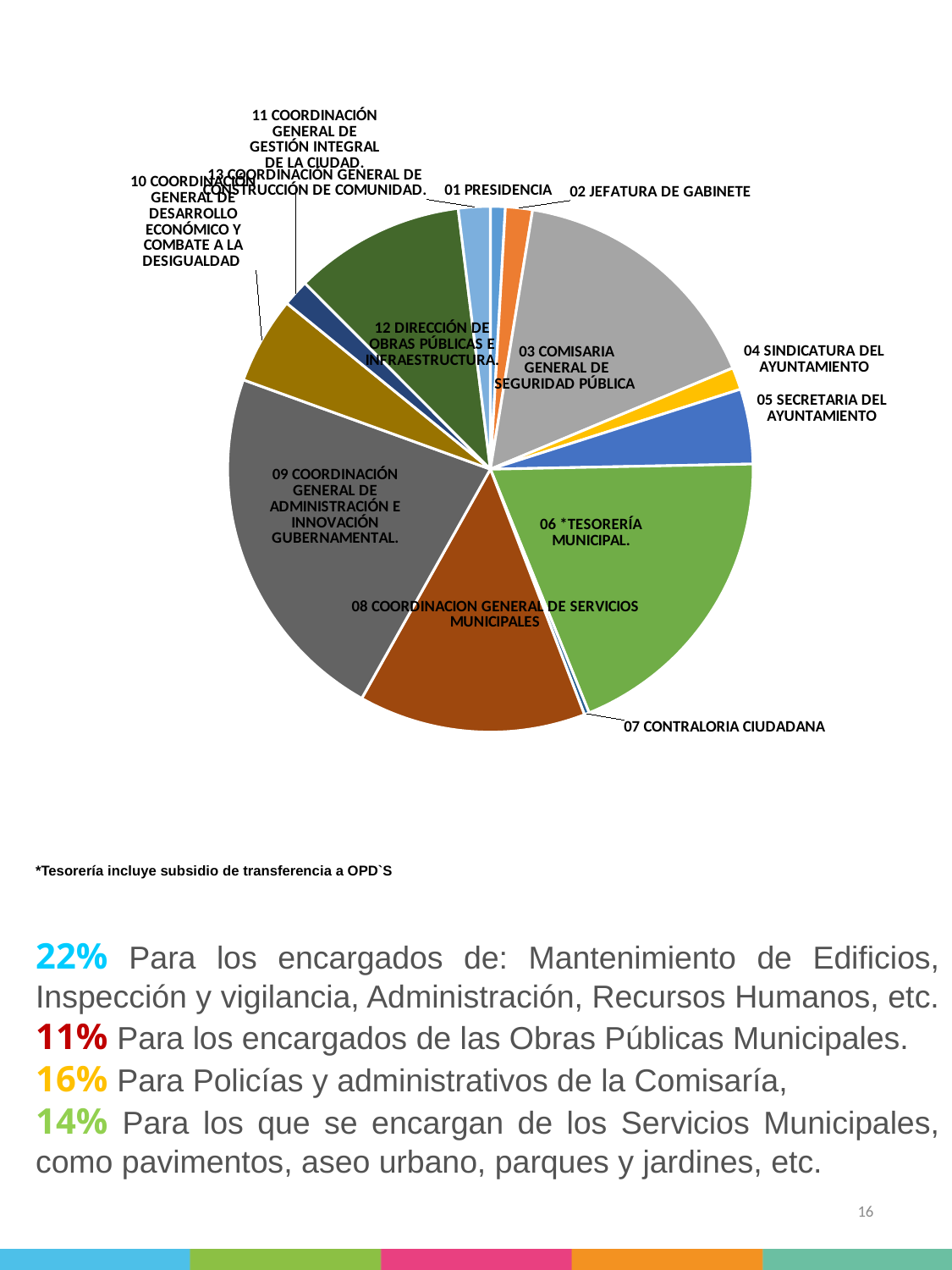
Which slice is larger: 02 JEFATURA DE GABINETE or 07 CONTRALORIA CIUDADANA? 02 JEFATURA DE GABINETE What does the footnote below the pie chart say? *Tesorería incluye subsidio de transferencia a OPD`S Which slice is larger: 09 COORDINACIÓN GENERAL DE ADMINISTRACIÓN E INNOVACIÓN GUBERNAMENTAL. or 06 *TESORERÍA MUNICIPAL.? 09 COORDINACIÓN GENERAL DE ADMINISTRACIÓN E INNOVACIÓN GUBERNAMENTAL. What kind of chart is shown on the slide? Pie chart Which slice is larger: 03 COMISARIA GENERAL DE SEGURIDAD PÚBLICA or 04 SINDICATURA DEL AYUNTAMIENTO? 03 COMISARIA GENERAL DE SEGURIDAD PÚBLICA Which category has the largest slice of the pie chart? 09 COORDINACIÓN GENERAL DE ADMINISTRACIÓN E INNOVACIÓN GUBERNAMENTAL. Which category has the smallest slice of the pie chart? 07 CONTRALORIA CIUDADANA What colour is the slice for 06 *TESORERÍA MUNICIPAL. in the pie chart? Green How many slices does the pie chart have? 13